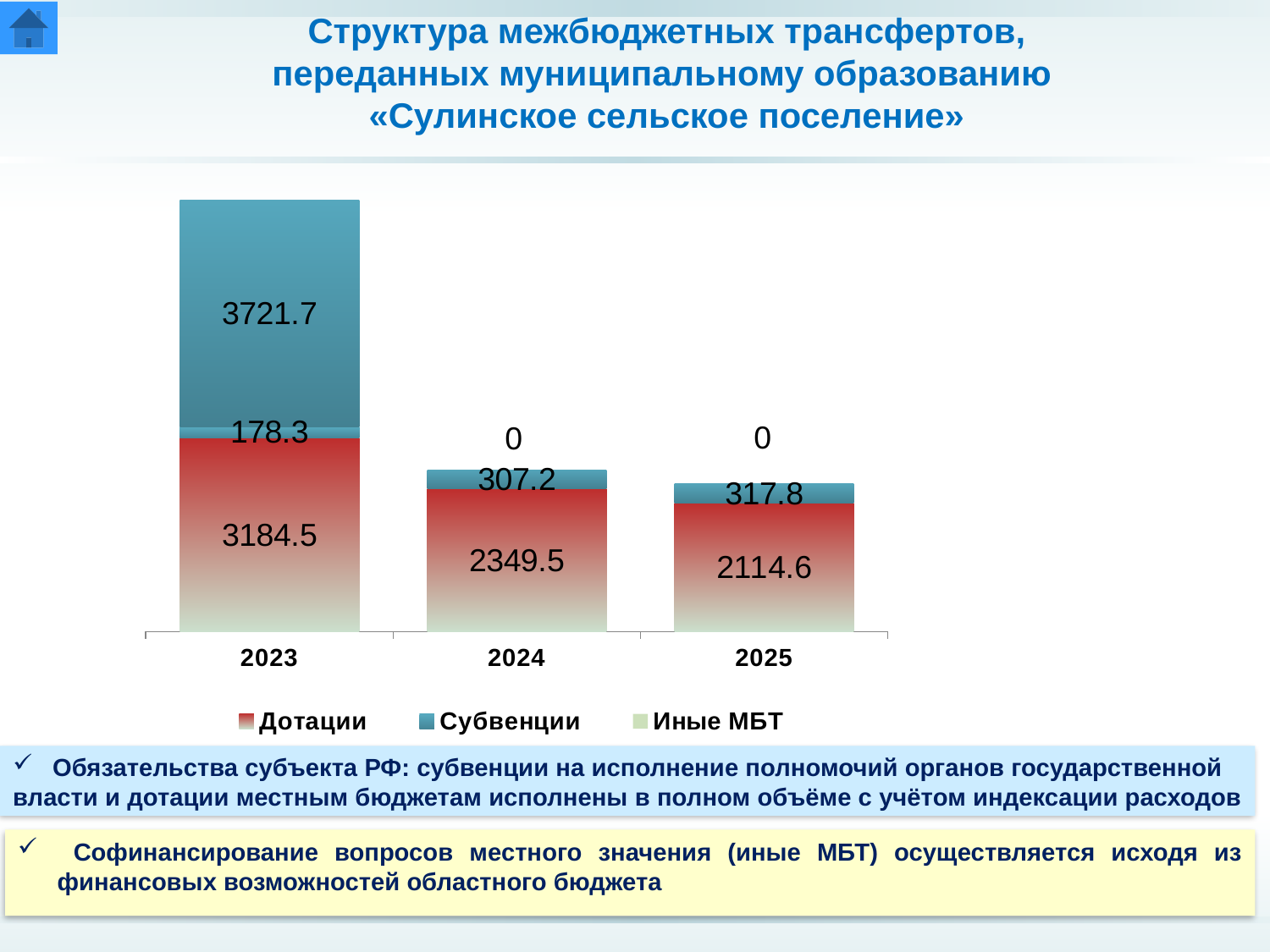
What is the total of the stacked bar for 2024? 2656.7 In which year is the value of Субвенции the highest? 2025 What is the value of Субвенции for 2025? 317.8 How many series does the legend list? 3 What is the difference between the Дотации values for 2023 and 2024? 835.0 Does the value of Дотации rise or fall from 2023 to 2025? fall What is the value of Иные МБТ for 2023? 3721.7 What is the value of Иные МБТ for 2024? 0 How many years (categories) are shown on the x axis? 3 What is the value of Дотации for 2023? 3184.5 What type of chart is shown on the slide? stacked bar chart In which year is the value of Дотации the lowest? 2025